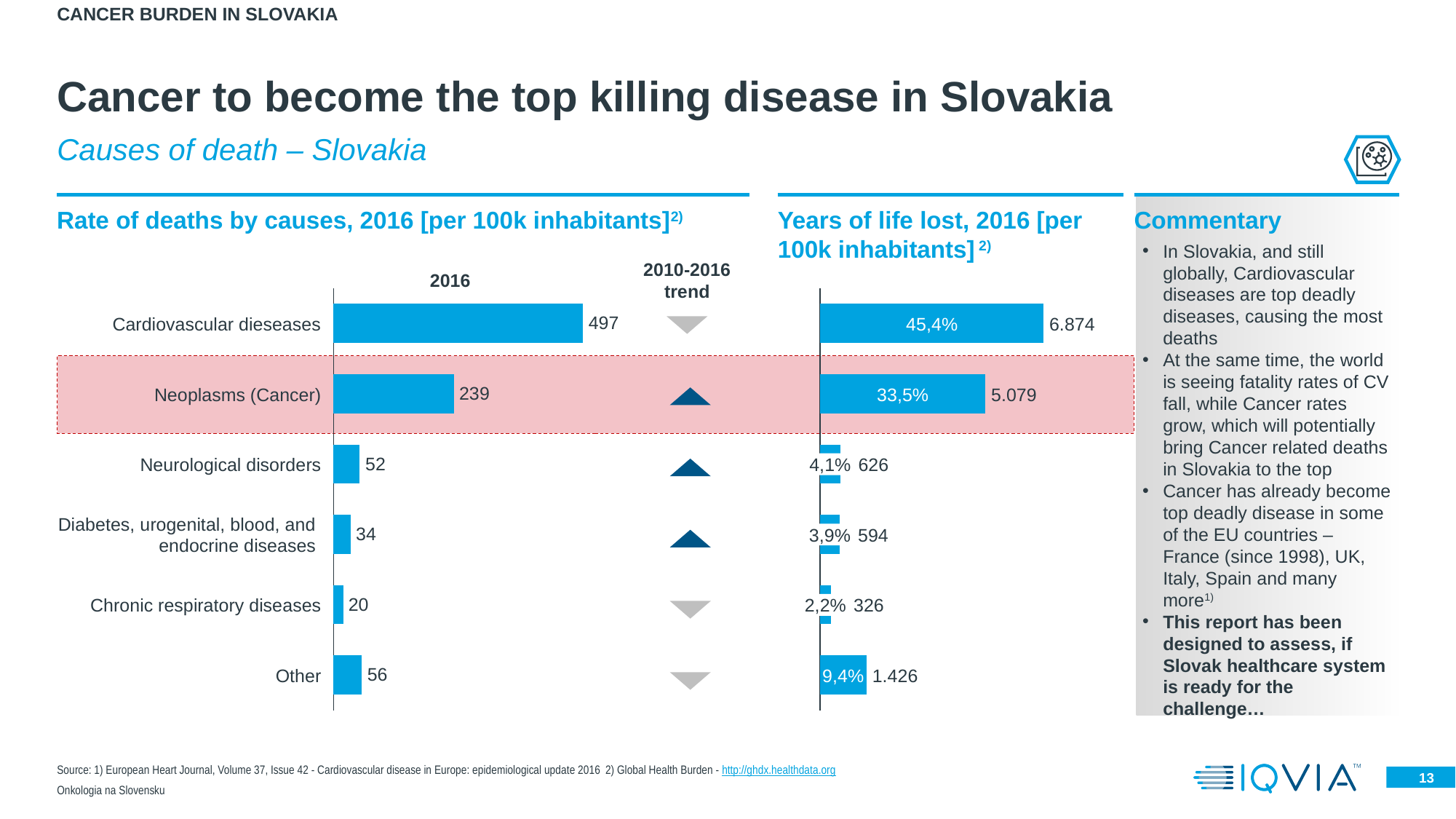
In the 'Rate of deaths by causes, 2016' chart, what is the value for Cardiovascular diseases? 497 In the 'Rate of deaths by causes, 2016' chart, what direction does the 2010-2016 trend arrow show for Neoplasms (Cancer)? Up In the 'Rate of deaths by causes, 2016' chart, which is larger: Neurological disorders or Other? Other What type of chart is the 'Years of life lost, 2016' chart? Bar chart In the 'Years of life lost, 2016' chart, what is the value for Neoplasms (Cancer)? 5.079 In the 'Years of life lost, 2016' chart, what percentage share is shown for Cardiovascular diseases? 45,4% In the 'Rate of deaths by causes, 2016' chart, what is the value for Neoplasms (Cancer)? 239 In the 'Years of life lost, 2016' chart, what percentage share is shown for Other? 9,4% In the 'Years of life lost, 2016' chart, which cause has the highest value? Cardiovascular diseases How many causes of death are listed in the 'Rate of deaths by causes, 2016' chart? 6 In the 'Rate of deaths by causes, 2016' chart, which cause has the lowest rate of deaths? Chronic respiratory diseases In the 'Rate of deaths by causes, 2016' chart, what is the difference between Cardiovascular diseases and Neoplasms (Cancer)? 258